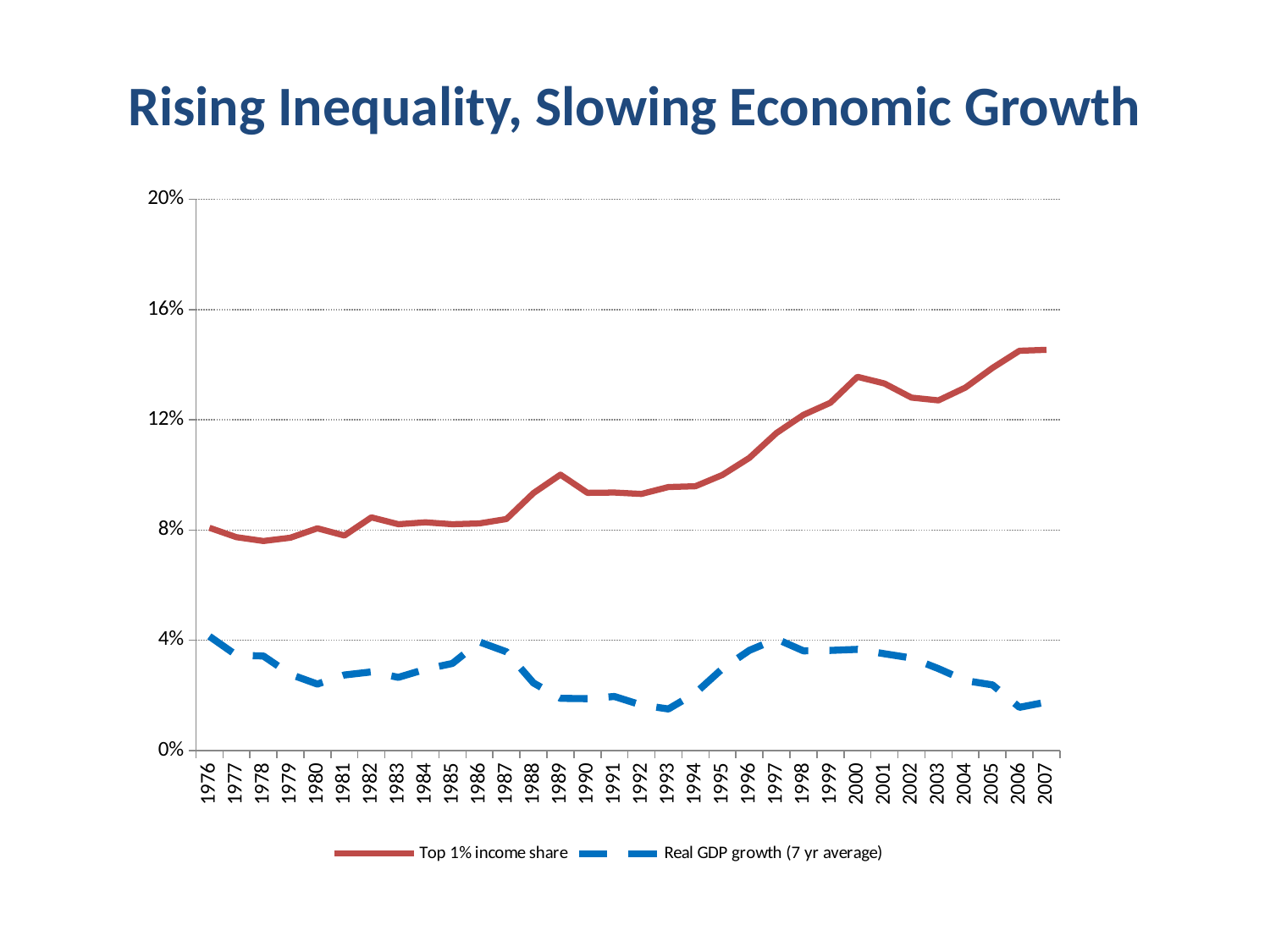
How many series does the legend list? 2 In 2000, which series has the higher value, Top 1% income share or Real GDP growth (7 yr average)? Top 1% income share Is the Top 1% income share in 2007 greater or less than 12%? greater Which is larger, the Top 1% income share in 2007 or in 1976? 2007 Does the Real GDP growth (7 yr average) line end higher or lower in 2007 than it started in 1976? lower What kind of chart is shown on the slide? line chart Does the Top 1% income share line generally rise or fall from 1976 to 2007? rise What is the title of the chart on the slide? Rising Inequality, Slowing Economic Growth How many years are plotted along the x axis? 32 Is the Top 1% income share in 1976 greater or less than 12%? less Is the Real GDP growth (7 yr average) in 1993 greater or less than 4%? less